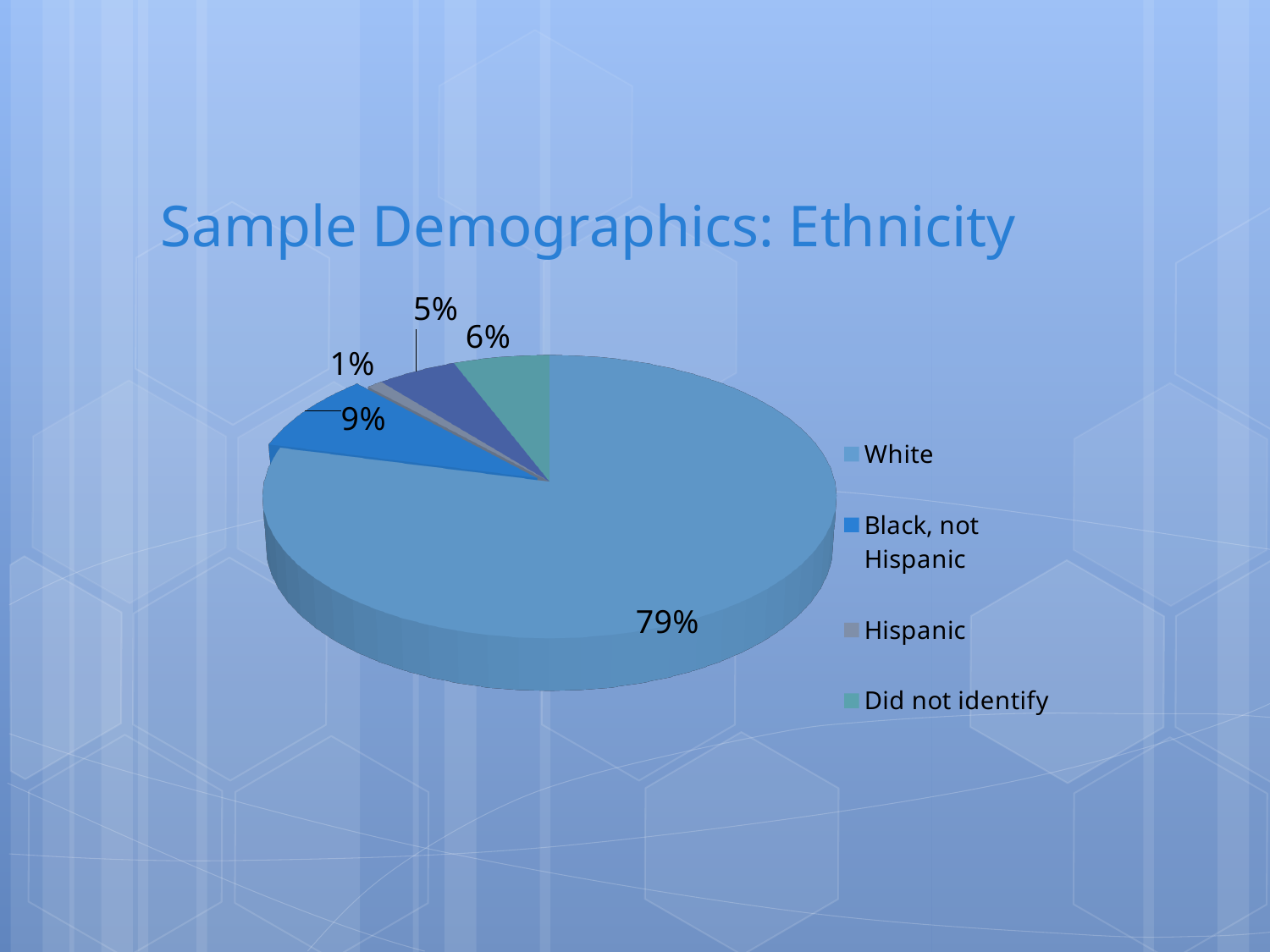
What is the title of the slide? Sample Demographics: Ethnicity Which is larger: the share for Black, not Hispanic or the share for Did not identify? Black, not Hispanic How many slices does the pie chart have? 5 What percentage of the sample is Hispanic? 1% Which ethnicity category has the largest share of the sample? White Which legend category has the smallest share of the sample? Hispanic What percentage of the sample is White? 79% What percentage of the sample did not identify their ethnicity? 6% What type of chart is shown on the slide? Pie chart How many categories are listed in the legend? 4 How many percentage points larger is the White share than the Black, not Hispanic share? 70 percentage points What percentage of the sample is Black, not Hispanic? 9%